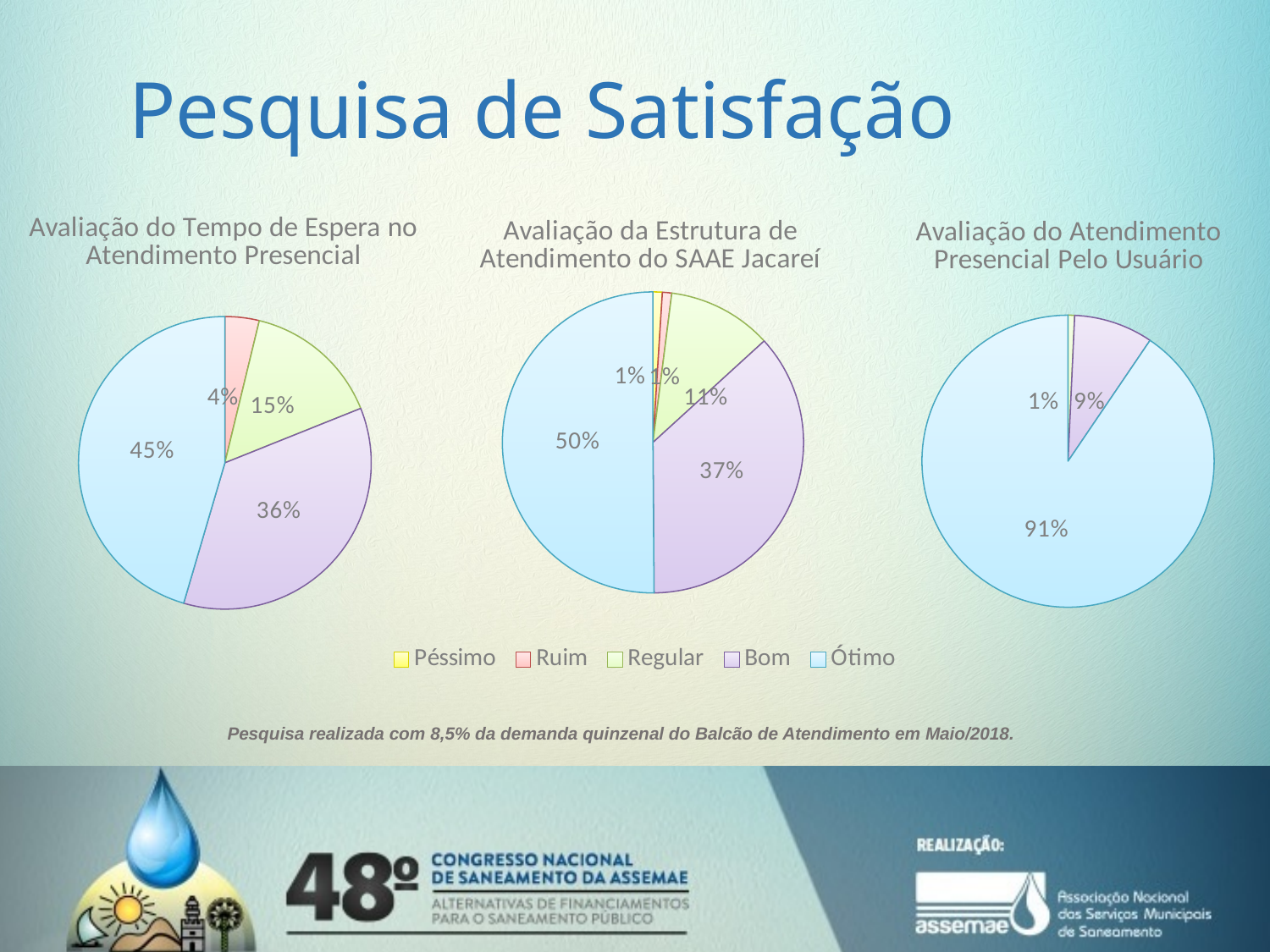
In the chart titled 'Avaliação do Atendimento Presencial Pelo Usuário', what share is labelled for the Bom slice? 9% In the chart titled 'Avaliação do Tempo de Espera no Atendimento Presencial', what share is labelled for the Regular slice? 15% In the chart titled 'Avaliação do Atendimento Presencial Pelo Usuário', what share is labelled for the Ótimo slice? 91% In the chart titled 'Avaliação do Tempo de Espera no Atendimento Presencial', what share is labelled for the Bom slice? 36% How many entries does the shared legend list? 5 In the chart titled 'Avaliação do Tempo de Espera no Atendimento Presencial', which category has the largest slice? Ótimo In the chart titled 'Avaliação da Estrutura de Atendimento do SAAE Jacareí', what share is labelled for the Regular slice? 11% In the chart titled 'Avaliação da Estrutura de Atendimento do SAAE Jacareí', what share is labelled for the Ótimo slice? 50% In the chart titled 'Avaliação da Estrutura de Atendimento do SAAE Jacareí', what is the difference between the Ótimo and Bom shares? 13% In the chart titled 'Avaliação do Tempo de Espera no Atendimento Presencial', what share is labelled for the Ruim slice? 4% In the chart titled 'Avaliação da Estrutura de Atendimento do SAAE Jacareí', what share is labelled for the Bom slice? 37% In the chart titled 'Avaliação do Tempo de Espera no Atendimento Presencial', what share is labelled for the Ótimo slice? 45%